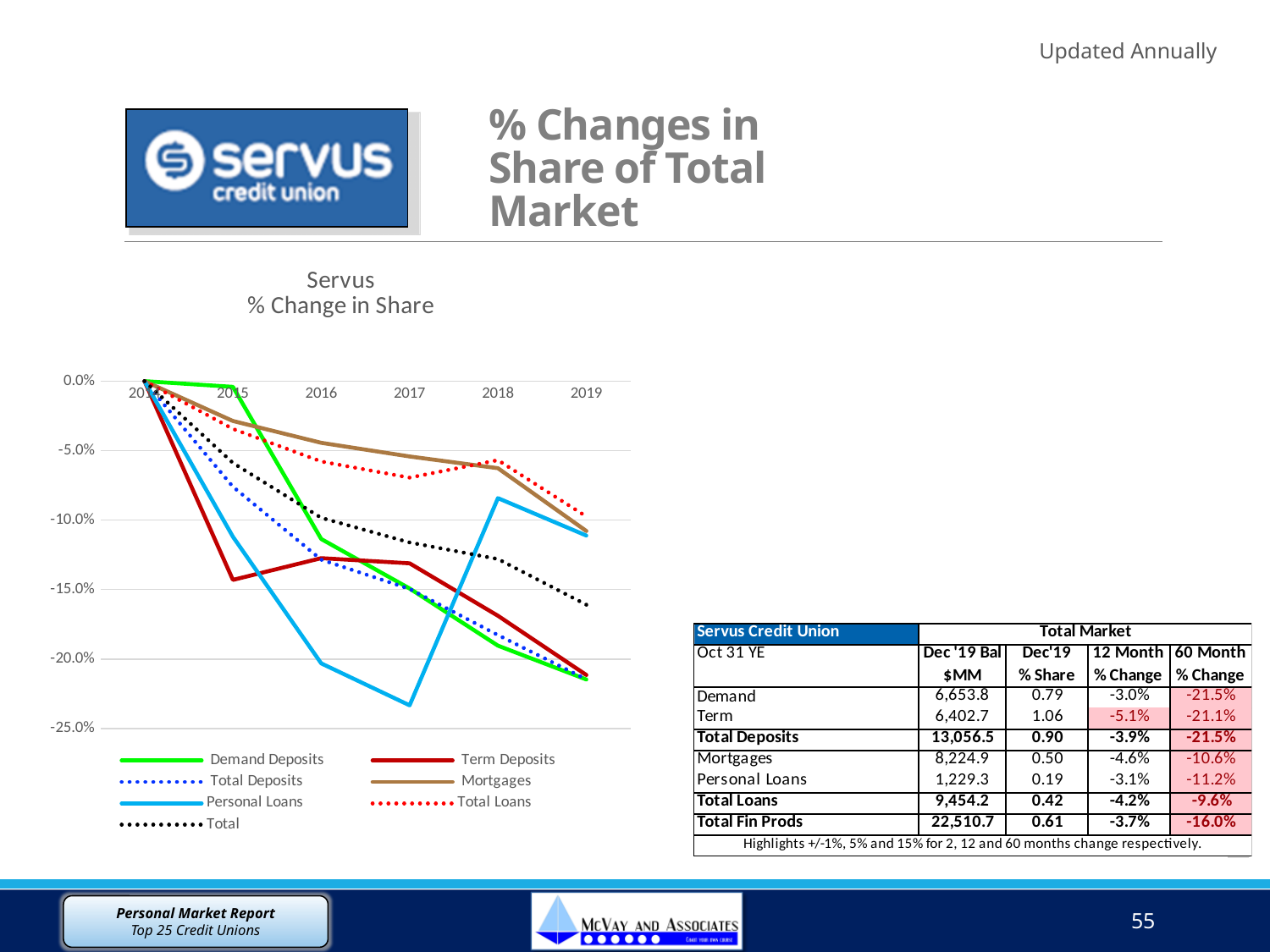
Which series has the lowest value in 2017? Personal Loans Does the Mortgages line rise or fall from 2015 to 2019? fall Is the value for Personal Loans in 2017 greater or less than -20.0%? less What kind of chart is shown on the slide? line chart Is the value for Term Deposits in 2015 greater or less than -10.0%? less Which series has the highest value in 2016? Mortgages What is the title of the chart? Servus % Change in Share How many series does the chart legend list? 7 Is the value for Total in 2019 greater or less than -20.0%? greater What colour is the Demand Deposits line in the chart? green In 2017, which is larger, the value for Mortgages or the value for Personal Loans? Mortgages